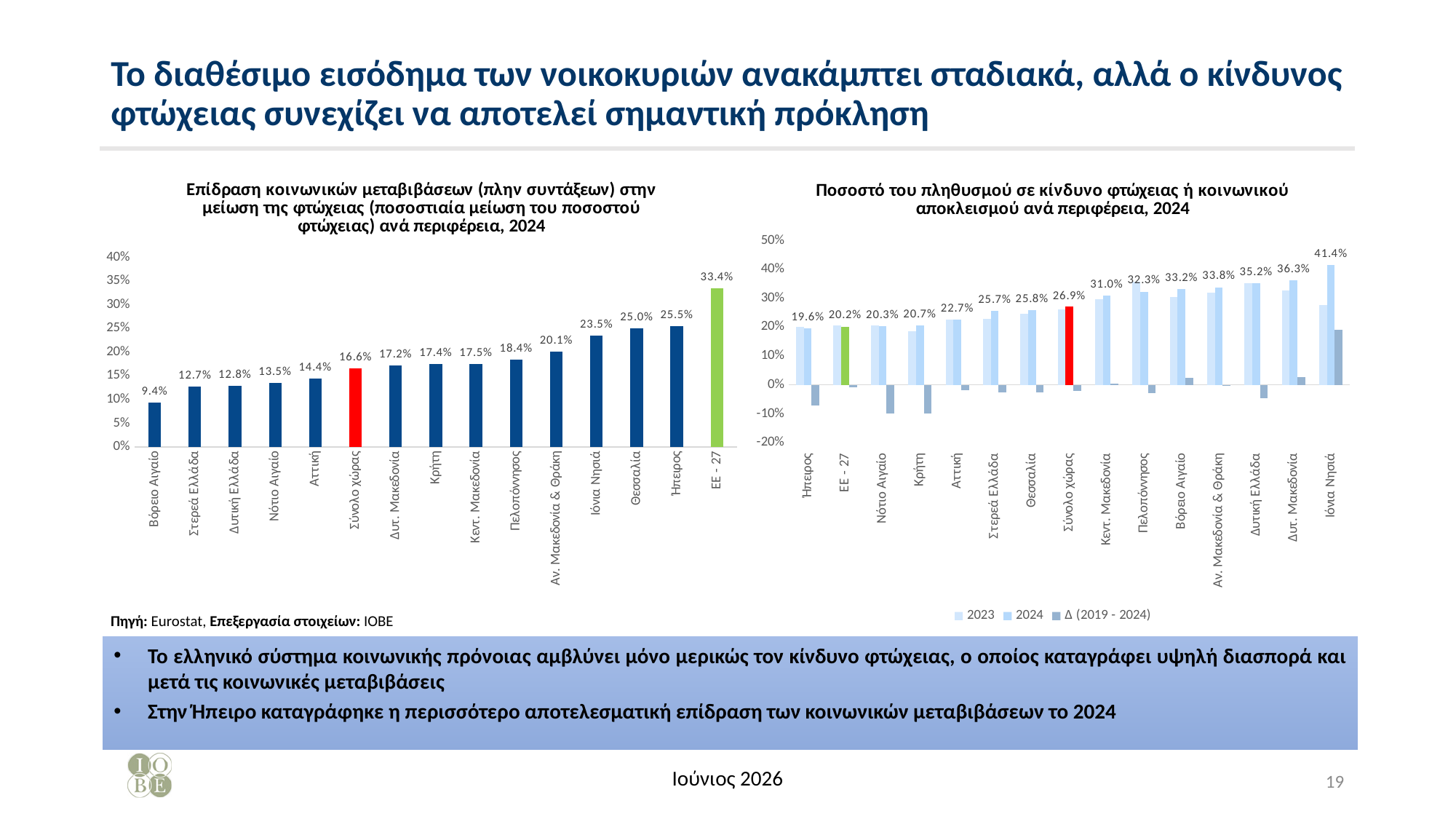
In the left chart (Επίδραση κοινωνικών μεταβιβάσεων), which category has the highest value? ΕΕ - 27 In the left chart (Επίδραση κοινωνικών μεταβιβάσεων), what is the value for Σύνολο χώρας? 16.6% What kind of chart is the right chart (Ποσοστό του πληθυσμού σε κίνδυνο φτώχειας)? bar chart In the left chart (Επίδραση κοινωνικών μεταβιβάσεων), how many bars are plotted? 15 In the right chart (Ποσοστό του πληθυσμού σε κίνδυνο φτώχειας), which has the larger labelled 2024 value, Αττική or Πελοπόννησος? Πελοπόννησος In the left chart (Επίδραση κοινωνικών μεταβιβάσεων), which category has the lowest value? Βόρειο Αιγαίο In the right chart (Ποσοστό του πληθυσμού σε κίνδυνο φτώχειας), what is the labelled 2024 value for Σύνολο χώρας? 26.9% In the right chart (Ποσοστό του πληθυσμού σε κίνδυνο φτώχειας), what is the labelled 2024 value for Ιόνια Νησιά? 41.4% In the left chart (Επίδραση κοινωνικών μεταβιβάσεων), what is the value for Ήπειρος? 25.5% In the left chart (Επίδραση κοινωνικών μεταβιβάσεων), do the values rise or fall from left to right? rise In the left chart (Επίδραση κοινωνικών μεταβιβάσεων), what is the difference between ΕΕ - 27 and Σύνολο χώρας? 16.8 percentage points In the right chart (Ποσοστό του πληθυσμού σε κίνδυνο φτώχειας), how many series does the legend list? 3